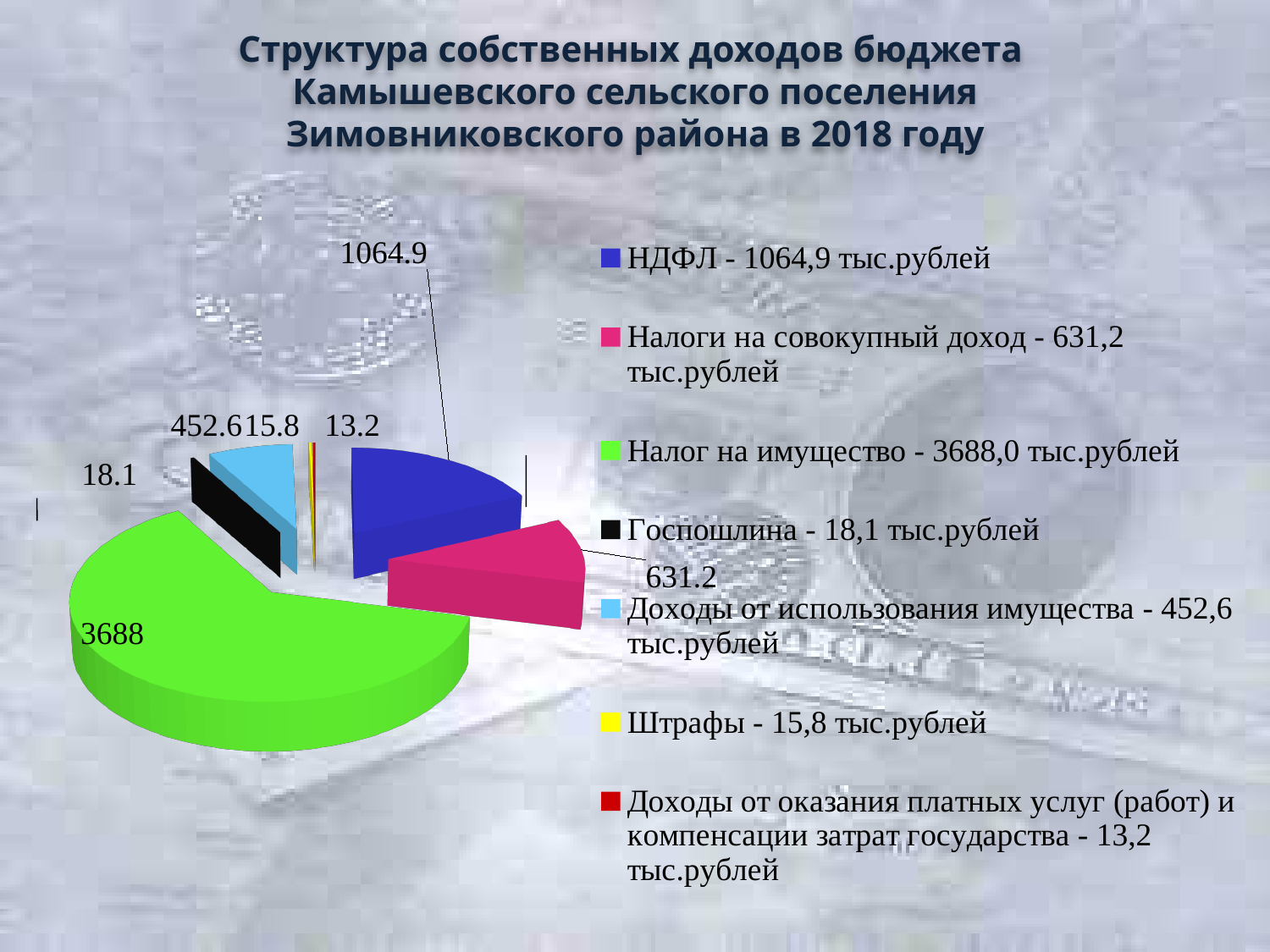
Which category has the largest slice of the pie chart? Налог на имущество How many categories does the pie chart have? 7 What is the value shown for Госпошлина on the pie chart? 18.1 What is the difference between the values for НДФЛ and Налоги на совокупный доход? 433.7 Which category has the smallest slice of the pie chart? Доходы от оказания платных услуг (работ) и компенсации затрат государства What is the value shown for НДФЛ on the pie chart? 1064.9 What colour is the slice for Налог на имущество? Green Which is larger: the value for Доходы от использования имущества or the value for Налоги на совокупный доход? Налоги на совокупный доход What is the total of all values shown on the pie chart? 5883.8 What is the value shown for Налог на имущество on the pie chart? 3688 What is the value shown for Штрафы on the pie chart? 15.8 What type of chart is shown on the slide? Pie chart